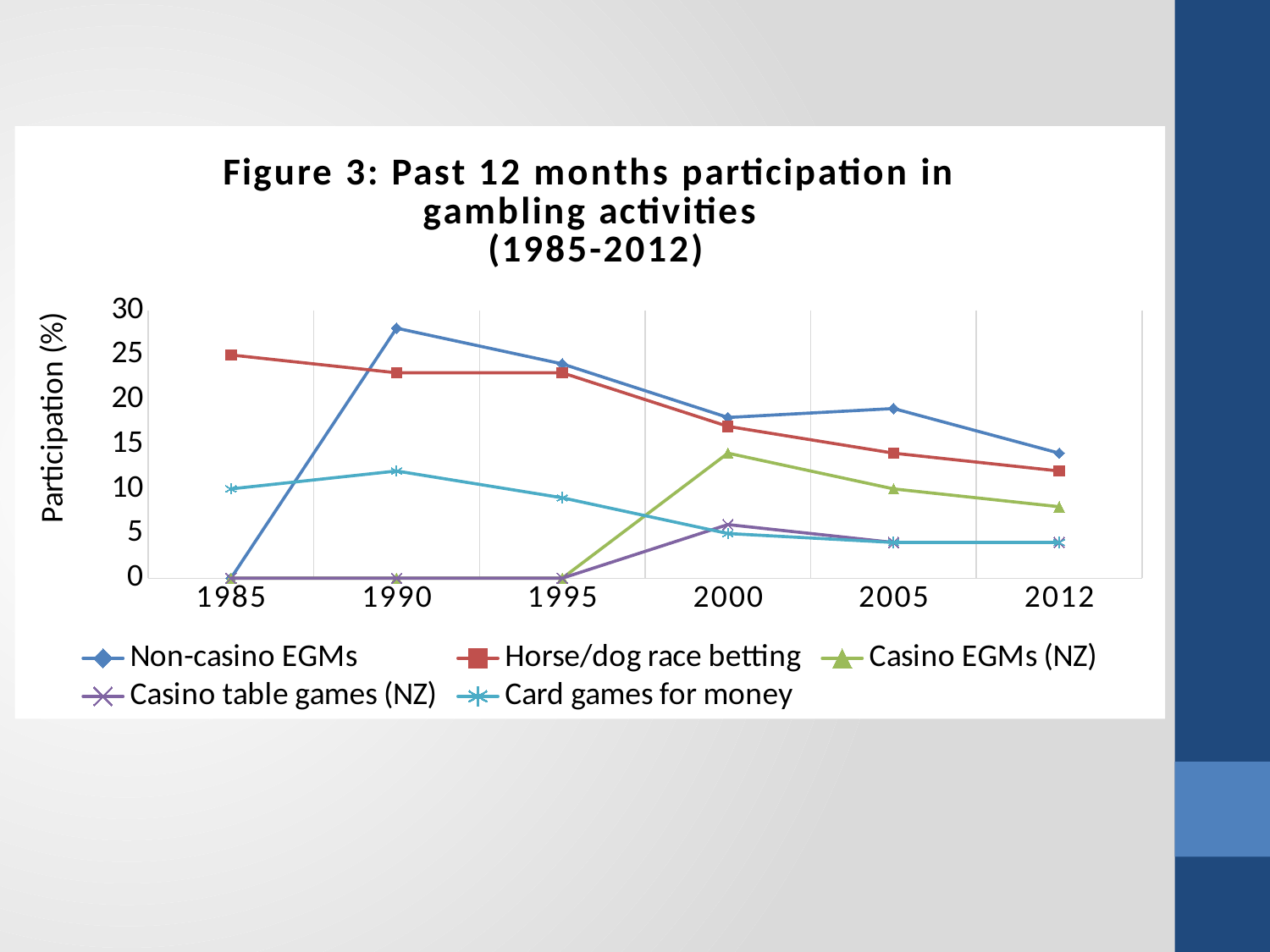
In 1990, which is larger: Non-casino EGMs or Horse/dog race betting? Non-casino EGMs Does the Horse/dog race betting series rise or fall from 1985 to 2012? fall What is the participation value for Non-casino EGMs in 1985? 0 How many years are plotted along the x axis? 6 What kind of chart is shown on the slide? line chart How many series does the legend list? 5 Is the value for Horse/dog race betting in 2005 greater or less than 15? less What is the participation value for Casino EGMs (NZ) in 1990? 0 Which series reaches the highest participation value anywhere on the chart? Non-casino EGMs Is the value for Non-casino EGMs in 1990 greater or less than 25? greater Is the value for Card games for money in 1990 greater or less than 10? greater Which series has the highest participation in 1985? Horse/dog race betting